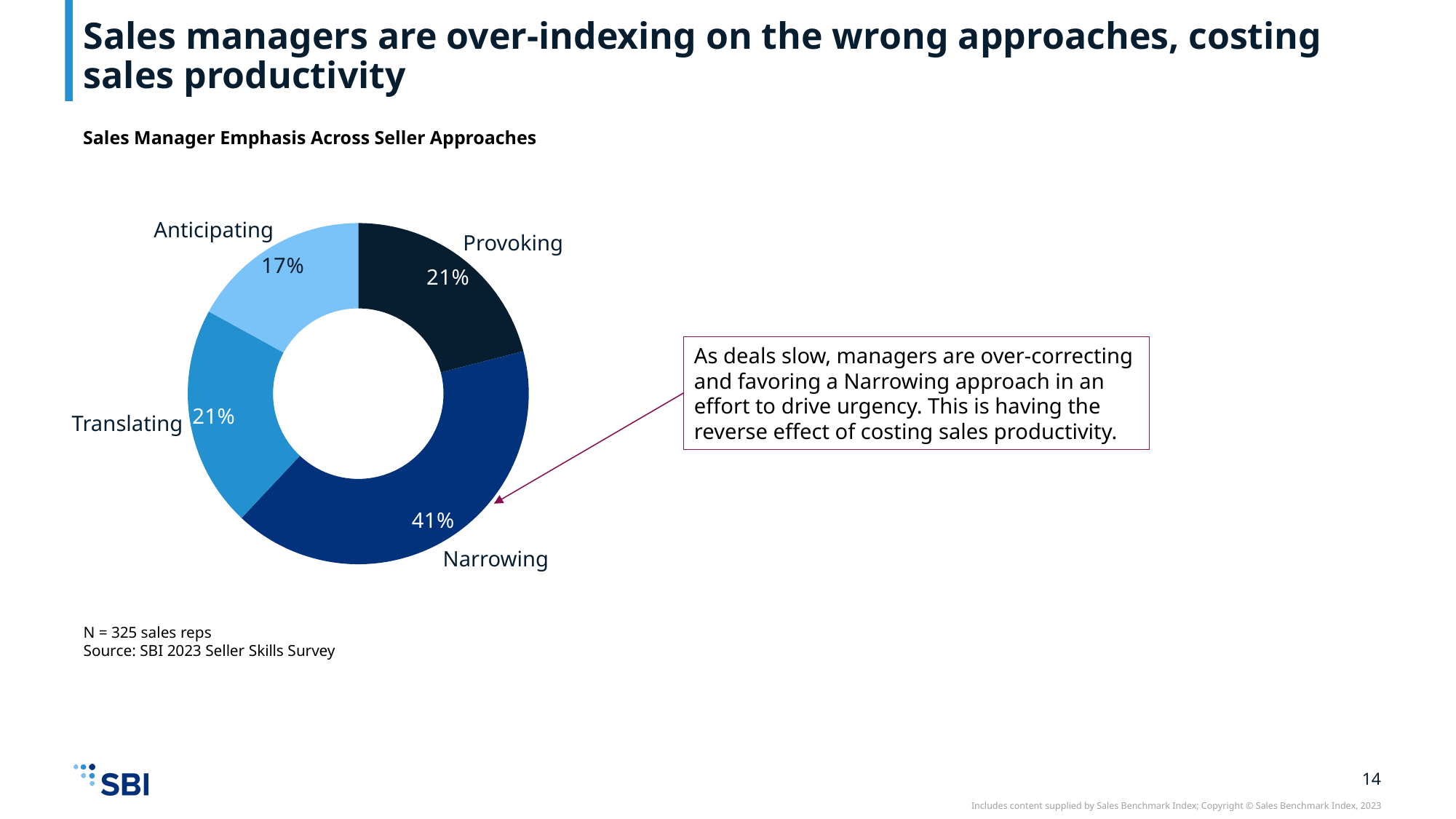
How many seller approaches are shown in the chart? 4 What is the difference in percentage points between Narrowing and Anticipating? 24 Which seller approach receives the smallest share of sales manager emphasis? Anticipating What kind of chart is used to show Sales Manager Emphasis Across Seller Approaches? Donut (pie) chart What percentage is shown for Translating? 21% Which has a larger share, Narrowing or Translating? Narrowing What is the title of the chart on the slide? Sales Manager Emphasis Across Seller Approaches What percentage is shown for Anticipating? 17% Which seller approach receives the largest share of sales manager emphasis? Narrowing What is the difference in percentage points between Provoking and Anticipating? 4 What percentage is shown for Provoking? 21% What percentage does the Narrowing approach receive in the Sales Manager Emphasis Across Seller Approaches chart? 41%